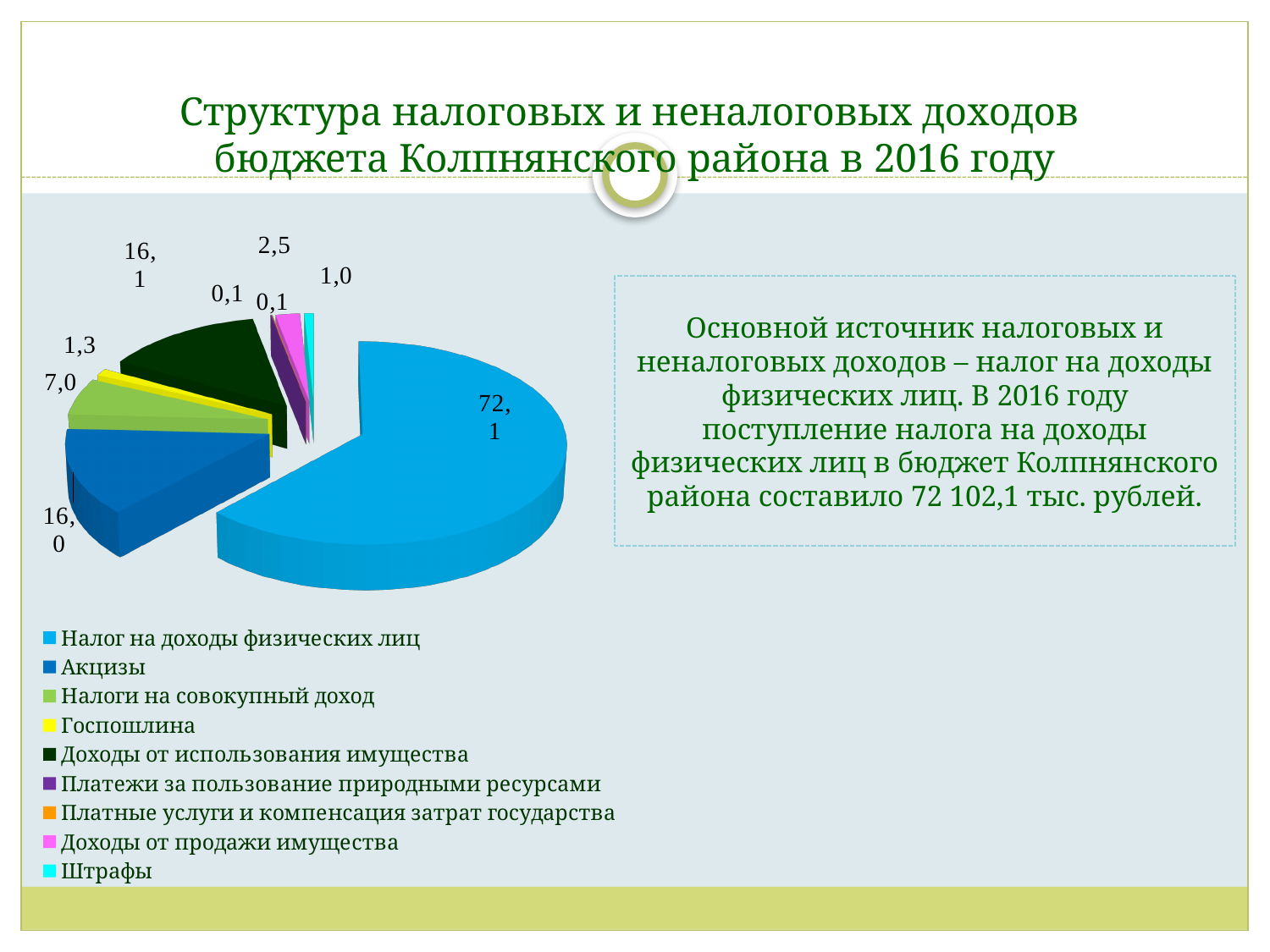
What is the value shown for Акцизы? 16,0 What is the title of the slide containing the chart? Структура налоговых и неналоговых доходов бюджета Колпнянского района в 2016 году Which is larger, the value for Акцизы or the value for Налоги на совокупный доход? Акцизы What is the value shown for Доходы от продажи имущества? 2,5 What kind of chart is shown on the slide? pie chart What is the value shown for Налог на доходы физических лиц? 72,1 What is the difference between the values for Акцизы and Налоги на совокупный доход? 9,0 What is the value shown for Штрафы? 1,0 What is the value shown for Налоги на совокупный доход? 7,0 What is the value shown for Госпошлина? 1,3 How many categories does the legend list? 9 Which category has the largest slice of the pie? Налог на доходы физических лиц